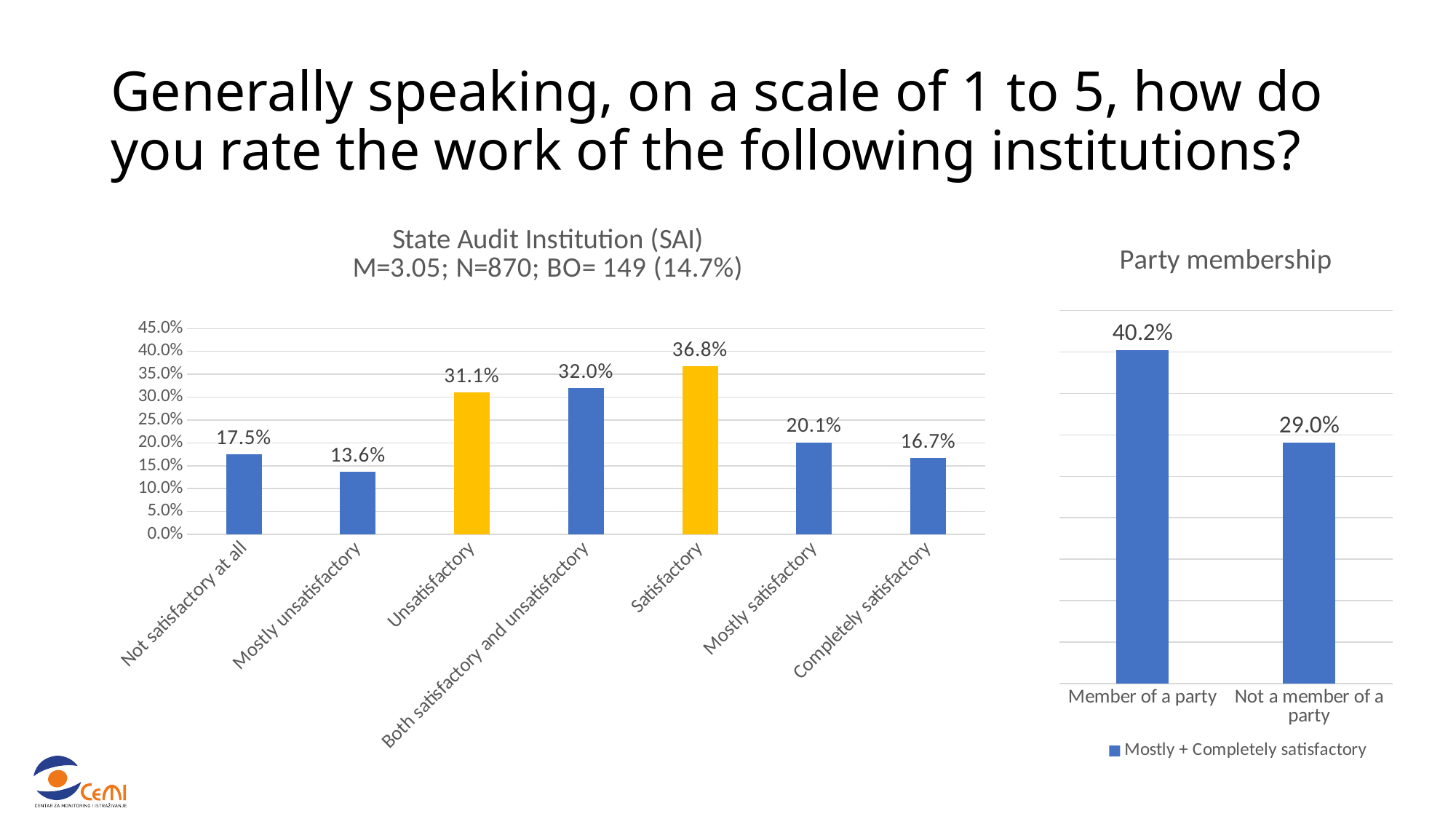
In the State Audit Institution (SAI) chart, which is larger: Mostly satisfactory or Completely satisfactory? Mostly satisfactory How many categories are shown in the State Audit Institution (SAI) chart? 7 In the State Audit Institution (SAI) chart, what is the difference between Satisfactory and Not satisfactory at all? 19.3% In the State Audit Institution (SAI) chart, which two categories are shown in yellow bars? Unsatisfactory and Satisfactory In the Party membership chart, what is the value for Member of a party? 40.2% In the State Audit Institution (SAI) chart, which category has the lowest value? Mostly unsatisfactory In the Party membership chart, what is the difference between Member of a party and Not a member of a party? 11.2% In the State Audit Institution (SAI) chart, which category has the highest value? Satisfactory What kind of chart is the State Audit Institution (SAI) chart? Bar chart In the State Audit Institution (SAI) chart, what is the value for Satisfactory? 36.8% In the State Audit Institution (SAI) chart, what is the value for Mostly unsatisfactory? 13.6% How many series does the legend of the Party membership chart list? 1